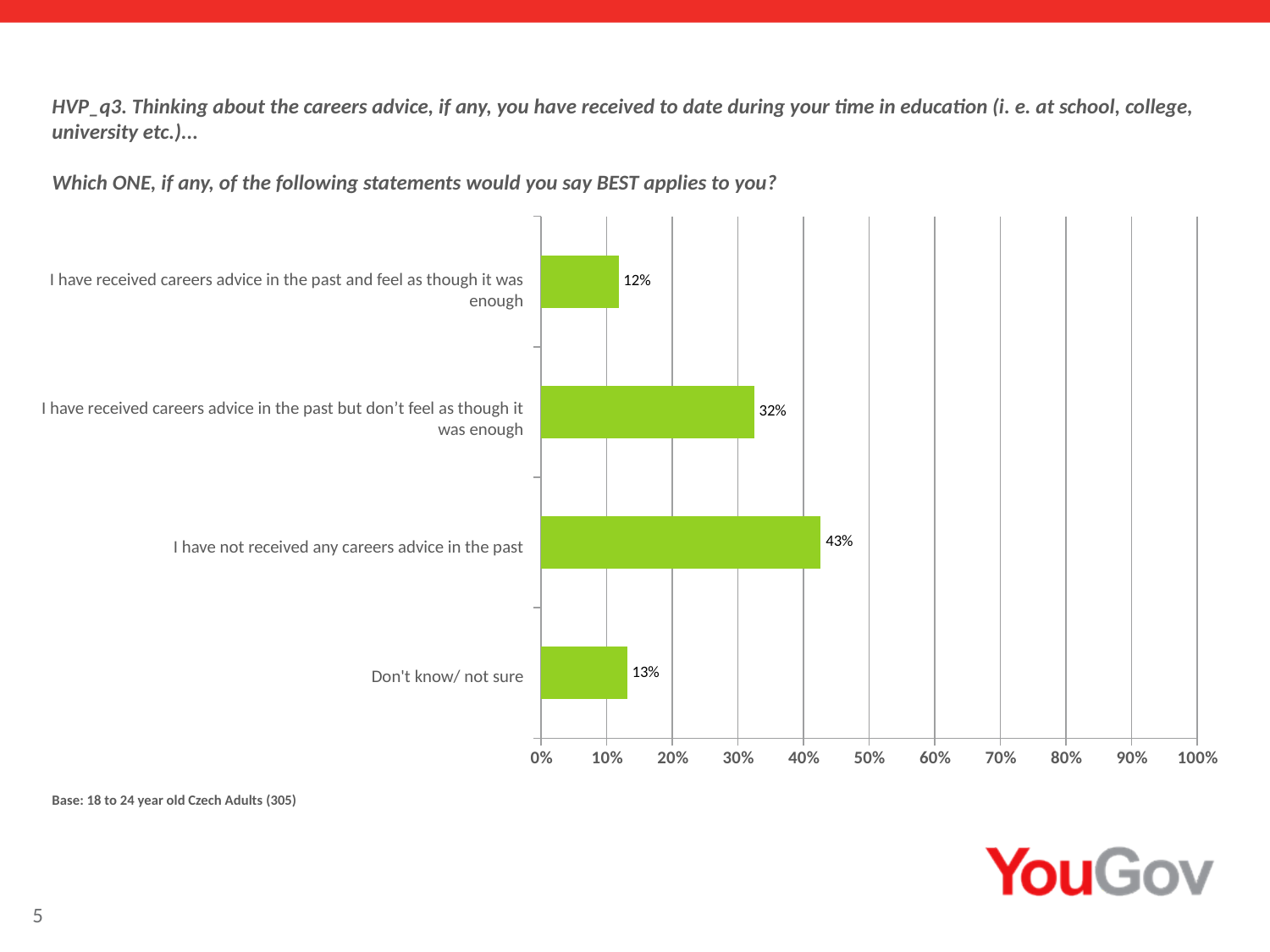
What is the difference in percentage points between 'I have not received any careers advice in the past' and 'I have received careers advice in the past but don't feel as though it was enough'? 11 percentage points What type of chart is shown on the slide? Bar chart What percentage of respondents said they have received careers advice in the past but don't feel as though it was enough? 32% What percentage of respondents said they have received careers advice in the past and feel as though it was enough? 12% How many response categories are shown in the chart? 4 Which statement has the highest percentage of respondents? I have not received any careers advice in the past Is the value for 'I have not received any careers advice in the past' greater or less than 40%? greater Which statement has the lowest percentage of respondents? I have received careers advice in the past and feel as though it was enough What percentage of respondents answered 'Don't know/ not sure'? 13% What percentage of respondents said they have not received any careers advice in the past? 43% Which is larger: the percentage for 'Don't know/ not sure' or the percentage for 'I have received careers advice in the past and feel as though it was enough'? Don't know/ not sure What is the base described below the chart? 18 to 24 year old Czech Adults (305)